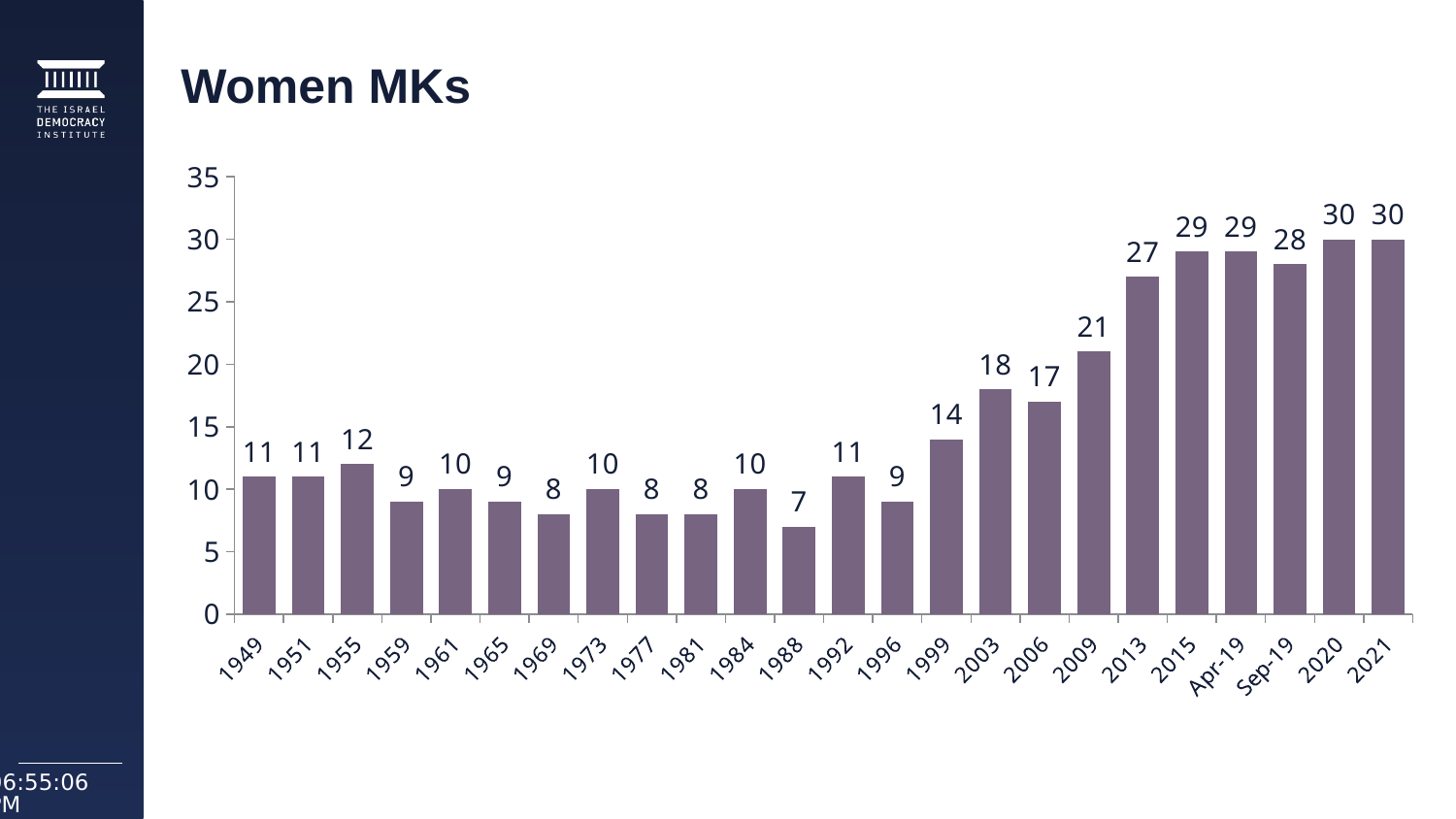
What is the value for 1999? 14 What is the value for Sep-19? 28 What is the difference between the values for 2013 and 2003? 9 What is the value for 1988? 7 Which is larger, the value for 2006 or the value for 2003? 2003 How many categories are shown on the x axis? 24 Is the value for 2015 greater or less than 25? greater What kind of chart is shown on the slide? Bar chart What is the title of the chart? Women MKs Which category has the lowest value? 1988 What is the value for 2009? 21 What is the highest value shown on the chart? 30